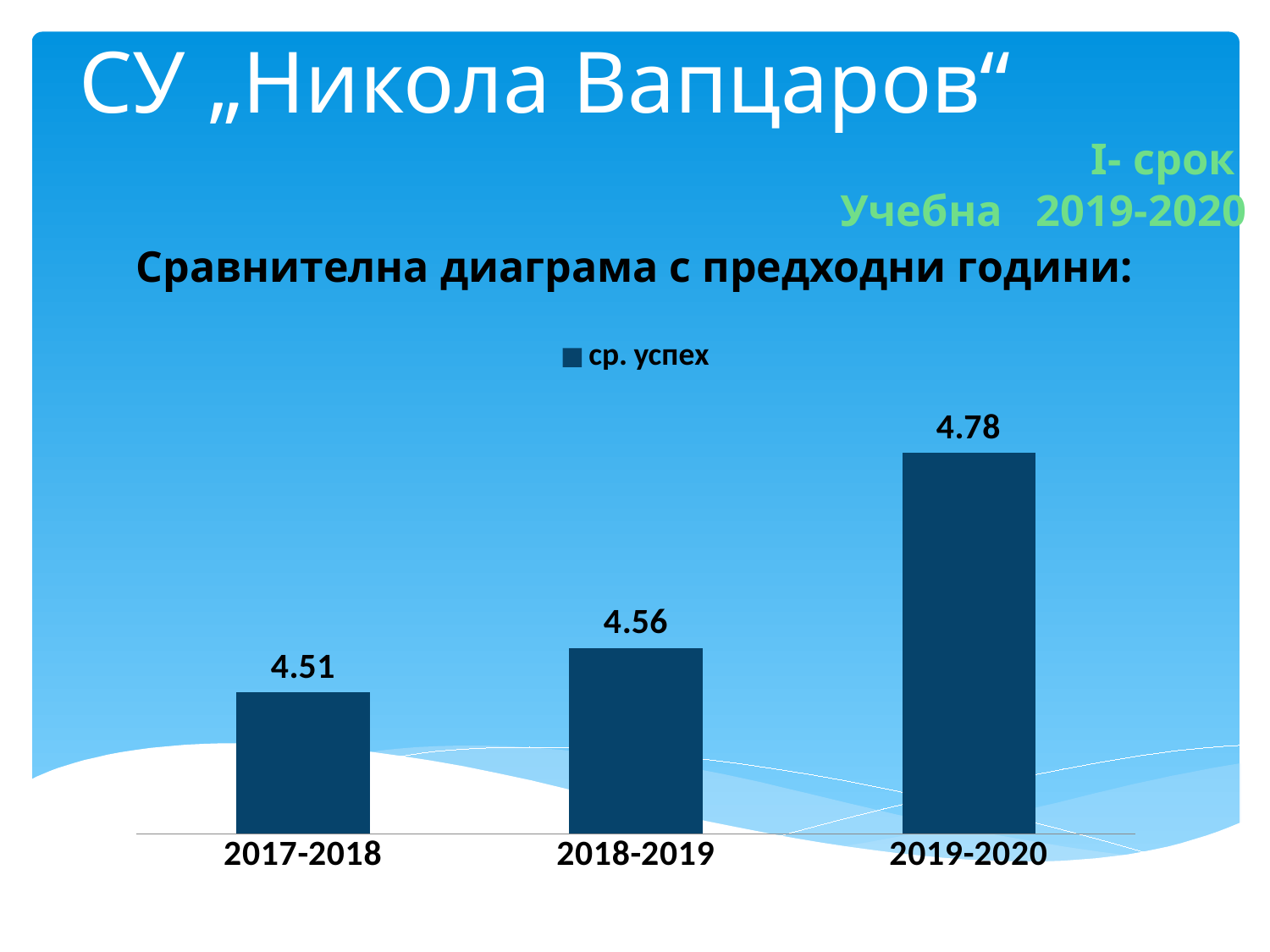
How many categories are shown on the x axis? 3 What kind of chart is shown? bar chart What is the difference between the values for 2018-2019 and 2017-2018? 0.05 Which year has the highest value? 2019-2020 Which is larger, the value for 2018-2019 or the value for 2019-2020? 2019-2020 What is the value for 2018-2019? 4.56 What is the value for 2019-2020? 4.78 Do the values rise or fall from 2017-2018 to 2019-2020? rise What is the difference between the values for 2019-2020 and 2017-2018? 0.27 Which year has the lowest value? 2017-2018 How many series does the legend list? 1 What is the value for 2017-2018? 4.51